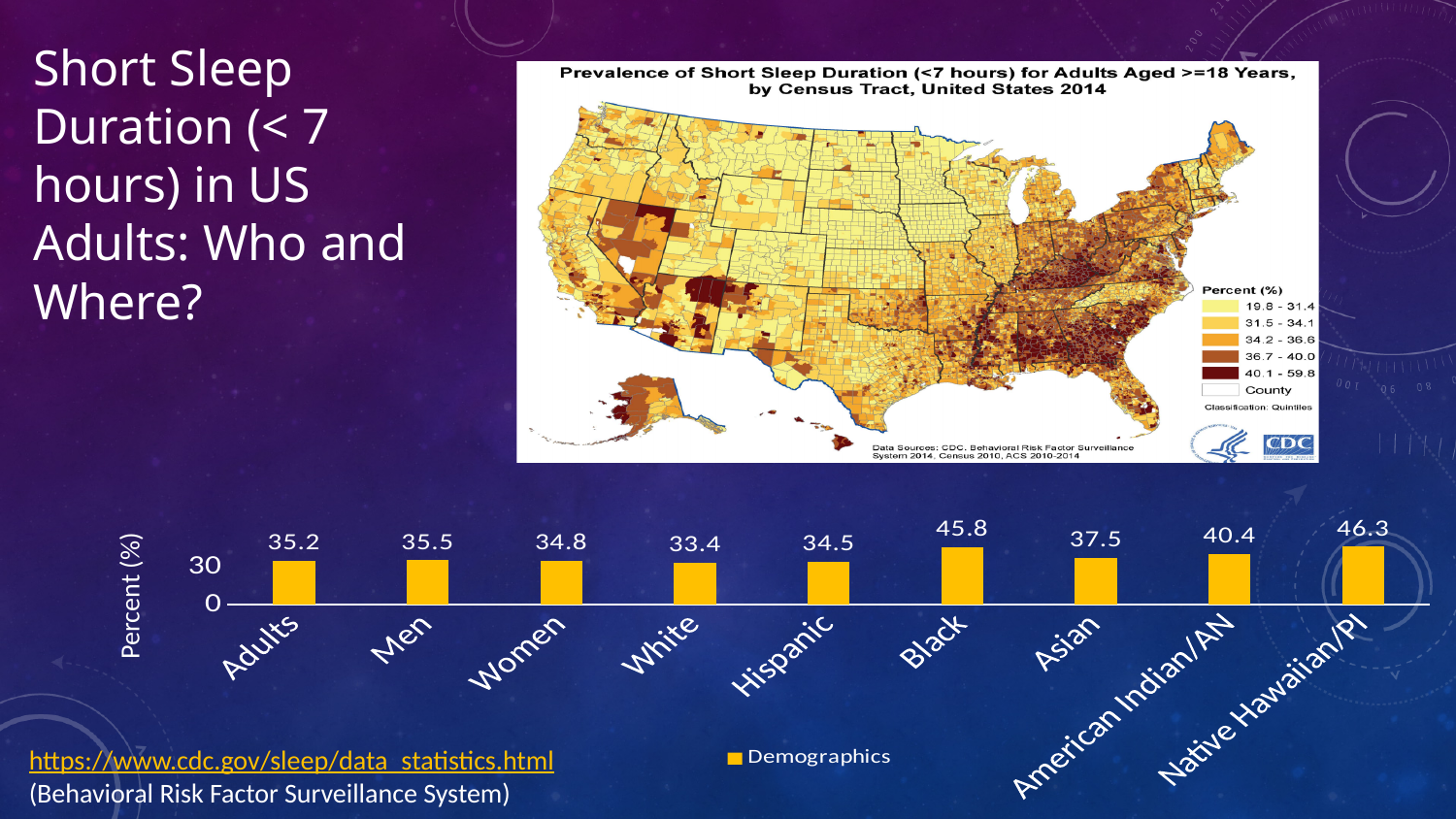
In the bar chart, how many series does the legend list? 1 In the bar chart, which category has the lowest value? White In the bar chart, which category has the highest value? Native Hawaiian/PI What kind of chart is shown at the bottom of the slide? bar chart In the bar chart, what is the difference between the values for Native Hawaiian/PI and White? 12.9 In the bar chart, what is the value for Women? 34.8 In the bar chart, what is the value for American Indian/AN? 40.4 In the bar chart, how many categories are shown? 9 In the bar chart, what is the difference between the values for Men and Women? 0.7 In the bar chart, what is the value for Black? 45.8 In the bar chart, which is larger, the value for Asian or the value for Hispanic? Asian In the bar chart, what is the label of the y axis? Percent (%)